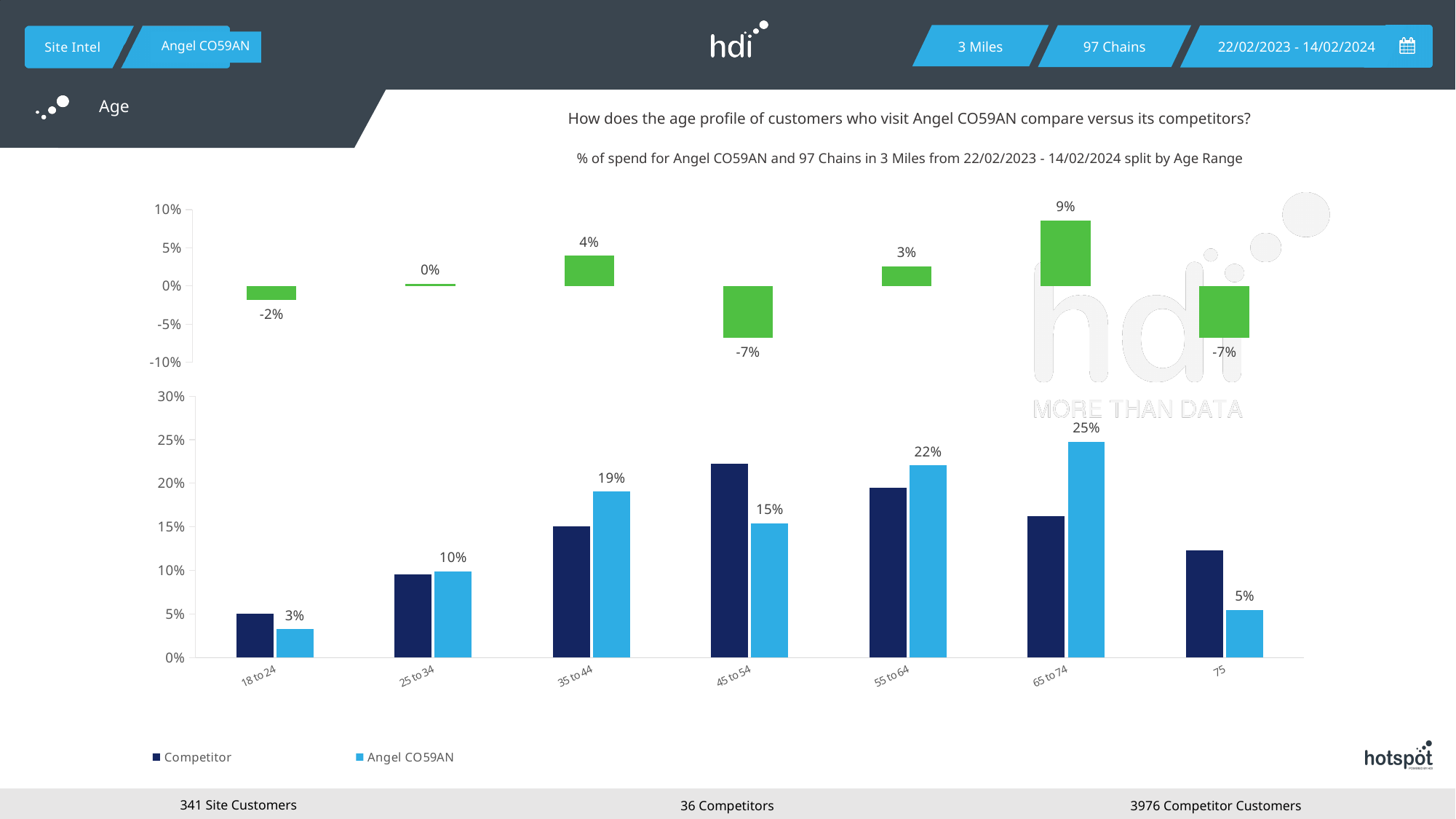
What kind of chart is the bottom chart on the slide? bar chart How many series does the legend of the bottom chart list? 2 In the top green difference chart, what is the value for the 65 to 74 age range? 9% In the bottom bar chart, which age range has the highest value for Angel CO59AN? 65 to 74 In the bottom bar chart, what is the value for Angel CO59AN in the 65 to 74 age range? 25% In the bottom bar chart, which age range has the lowest value for Angel CO59AN? 18 to 24 In the bottom bar chart, what is the difference between the Angel CO59AN values for 65 to 74 and 18 to 24? 22% In the bottom bar chart, is the Competitor value for the 75 age range greater or less than 10%? greater In the bottom bar chart, is the Competitor value for the 45 to 54 age range greater or less than 20%? greater In the bottom bar chart, what is the value for Angel CO59AN in the 35 to 44 age range? 19% How many age range categories are shown on the x axis of the bottom bar chart? 7 In the bottom bar chart, for the 45 to 54 age range, which series has the larger value, Competitor or Angel CO59AN? Competitor